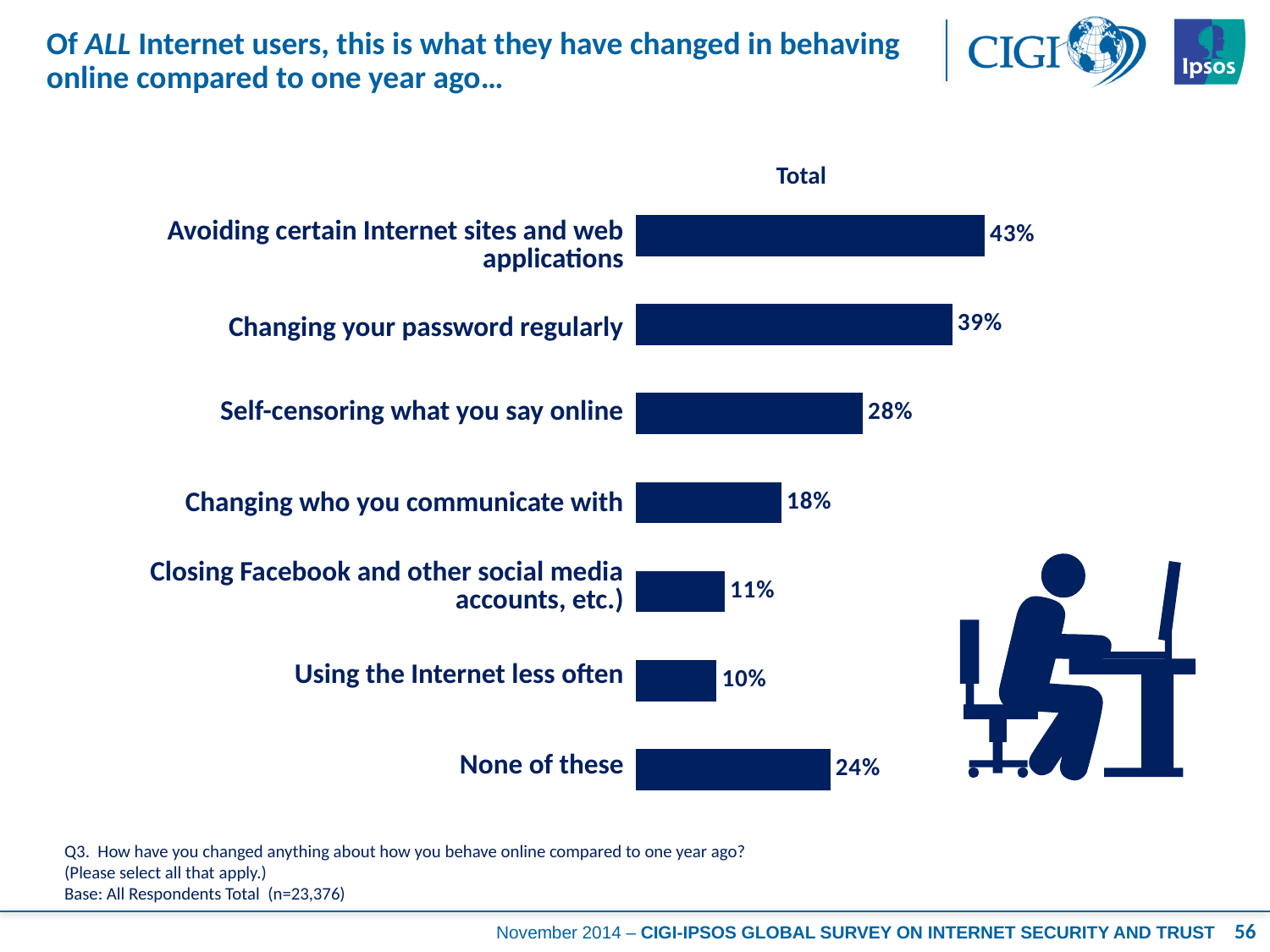
Which behaviour change has the highest percentage? Avoiding certain Internet sites and web applications What percentage of Internet users report avoiding certain Internet sites and web applications? 43% What is the value for 'Closing Facebook and other social media accounts, etc.)'? 11% What is the difference between 'Avoiding certain Internet sites and web applications' and 'Changing your password regularly'? 4% Which is larger: 'None of these' or 'Changing who you communicate with'? None of these What type of chart is shown on the slide? Bar chart What percentage selected 'None of these'? 24% How many categories are shown in the chart? 7 What is the label shown above the bars in the chart? Total What is the value shown for 'Changing your password regularly'? 39% What is the difference between 'Self-censoring what you say online' and 'Changing who you communicate with'? 10% Which category has the lowest percentage? Using the Internet less often